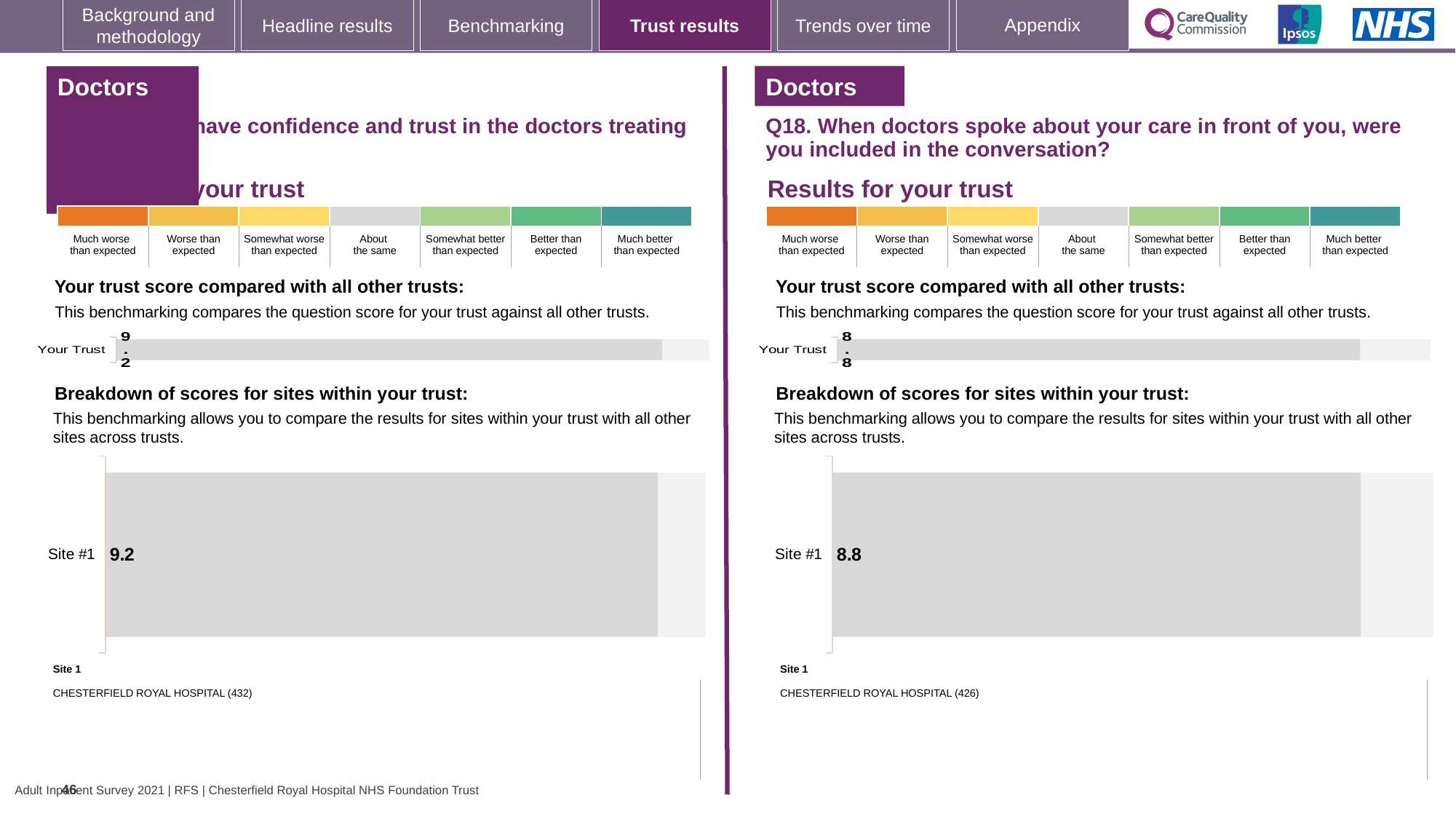
What is the difference between the Your Trust value on the left-hand chart (9.2) and the Your Trust value on the right-hand Q18 chart (8.8)? 0.4 On the right-hand 'Breakdown of scores for sites within your trust' chart (Q18), what is the value for Site #1? 8.8 What is the category label on the right-hand 'Your trust score compared with all other trusts' chart? Your Trust On the left-hand 'Breakdown of scores for sites within your trust' chart, what is the value for Site #1? 9.2 On the left-hand 'Your trust score compared with all other trusts' chart, what is the value for Your Trust? 9.2 Which hospital is listed as Site 1 beneath the right-hand breakdown chart? CHESTERFIELD ROYAL HOSPITAL (426) What kind of chart is used for the 'Breakdown of scores for sites within your trust' on the right-hand side? Bar chart How many sites are plotted on the left-hand 'Breakdown of scores for sites within your trust' chart? 1 On the right-hand 'Your trust score compared with all other trusts' chart (Q18), what is the value for Your Trust? 8.8 How many sites are plotted on the right-hand 'Breakdown of scores for sites within your trust' chart? 1 Which is larger: the Site #1 value on the left-hand breakdown chart or the Site #1 value on the right-hand breakdown chart? Left-hand (9.2)